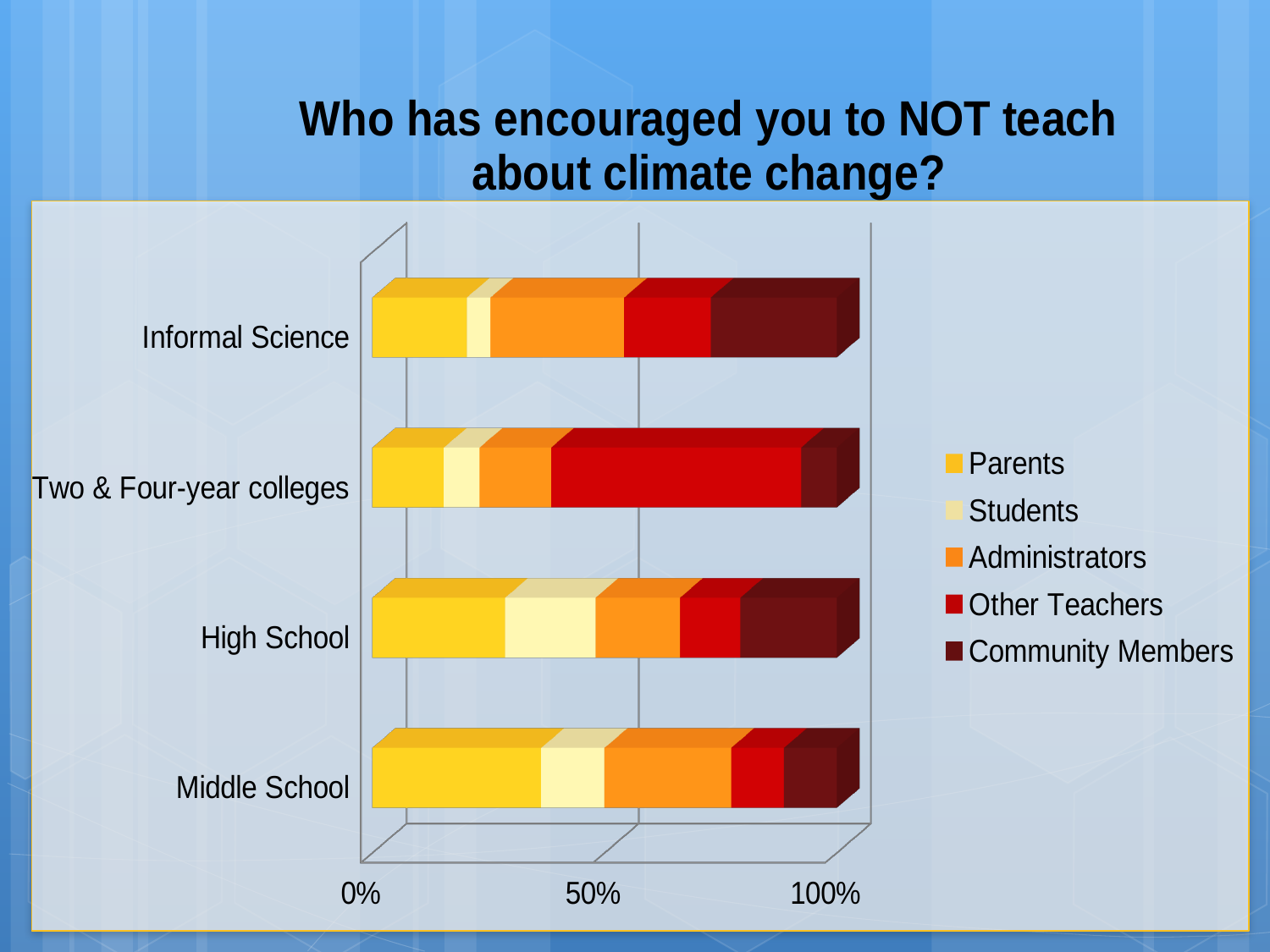
Is the Students segment larger for High School or for Two & Four-year colleges? High School How many series does the chart's legend list? 5 Which series is shown in the darkest red colour in the legend? Community Members Which category has the largest Other Teachers segment? Two & Four-year colleges Which category has the largest Parents segment? Middle School What is the title of the chart? Who has encouraged you to NOT teach about climate change? Which category has the largest Community Members segment? Informal Science Is the Parents share for Middle School greater or less than 50%? less How many categories are shown on the vertical axis of the chart? 4 Is the Parents segment larger for Middle School or for Informal Science? Middle School What kind of chart is shown on the slide? Stacked bar chart Which category has the smallest Students segment? Informal Science